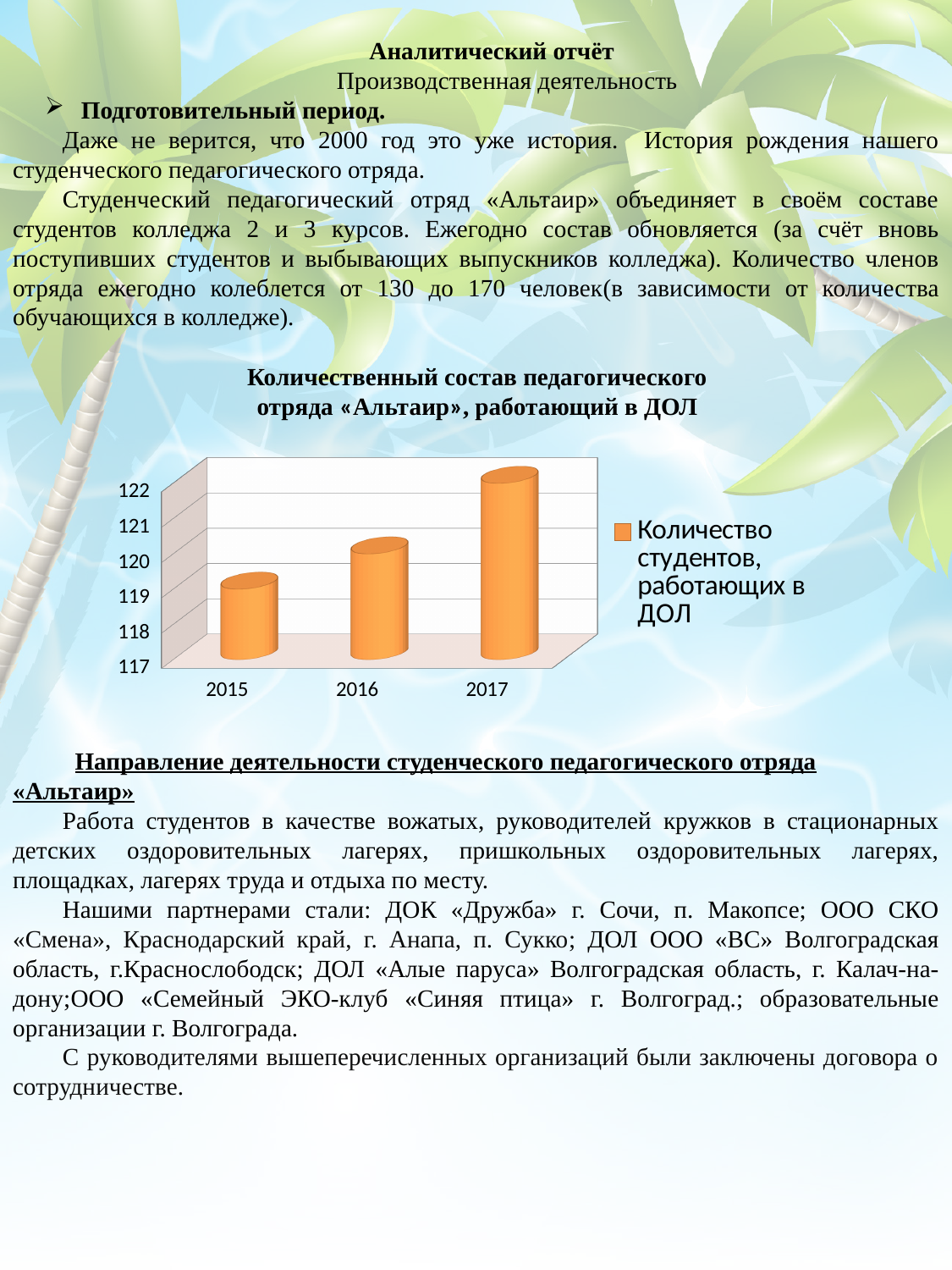
Which is larger, the value for 2016 or the value for 2017? 2017 Which year has the highest number of students working in ДОЛ? 2017 Which year has the lowest number of students working in ДОЛ? 2015 Which is larger, the value for 2015 or the value for 2016? 2016 How many series does the chart legend list? 1 Is the value for 2015 greater or less than 121? less Is the value for 2016 greater or less than 118? greater How many years are shown on the x axis of the chart? 3 Do the values rise or fall from 2015 to 2017? rise What kind of chart is shown on the slide? bar chart Is the value for 2017 greater or less than 121? greater What is the legend entry of the chart? Количество студентов, работающих в ДОЛ